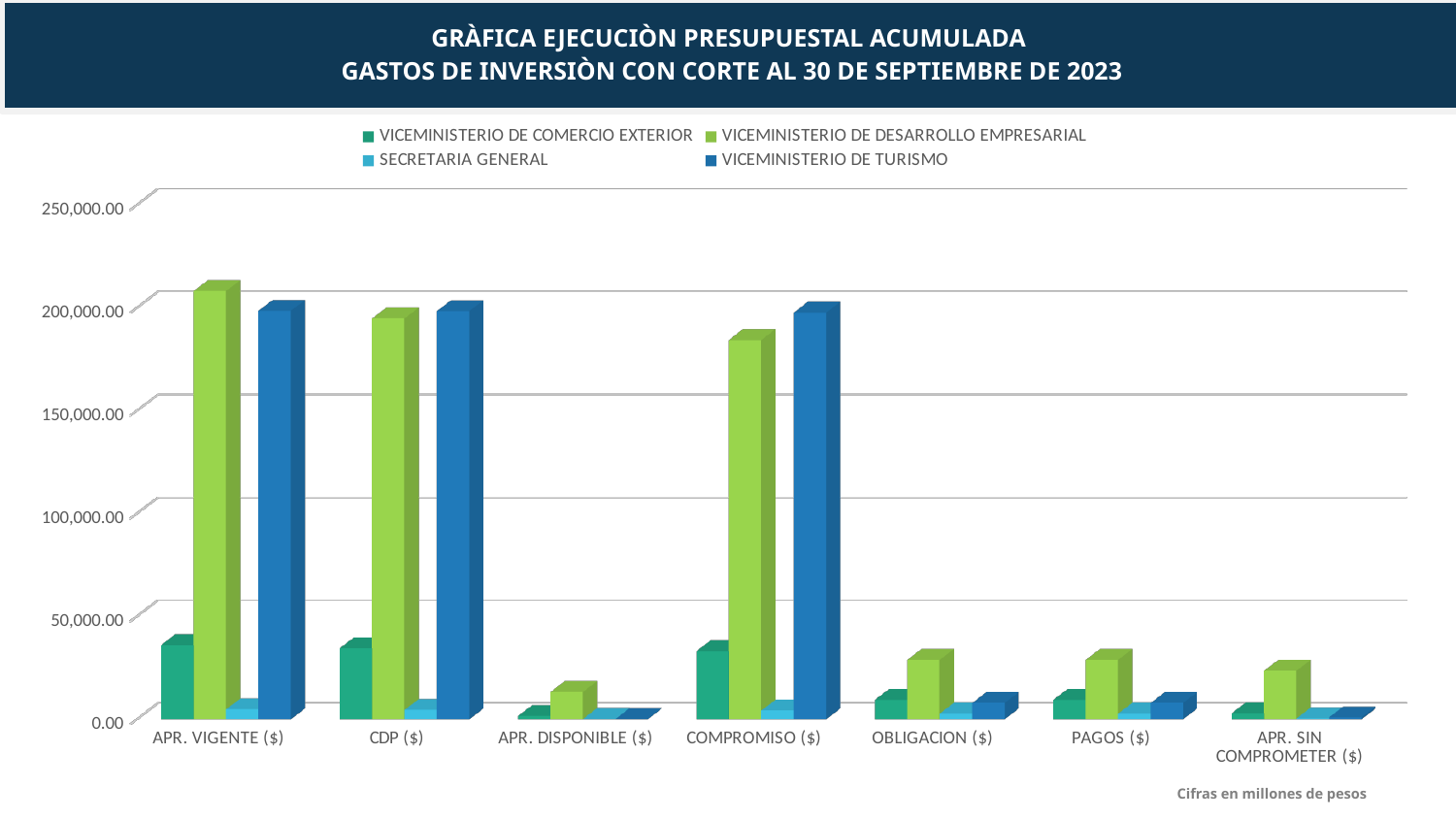
Is the value for VICEMINISTERIO DE DESARROLLO EMPRESARIAL in APR. VIGENTE ($) greater or less than 150,000.00? greater In which category does VICEMINISTERIO DE DESARROLLO EMPRESARIAL have its lowest value? APR. DISPONIBLE ($) Is the value for VICEMINISTERIO DE DESARROLLO EMPRESARIAL in COMPROMISO ($) greater or less than 200,000.00? less Is the value for VICEMINISTERIO DE TURISMO in CDP ($) greater or less than 150,000.00? greater According to the note below the chart, in what units are the figures expressed? millones de pesos In which category does VICEMINISTERIO DE DESARROLLO EMPRESARIAL have its highest value? APR. VIGENTE ($) How many categories are shown along the x axis? 7 Which series has the lowest value in the APR. VIGENTE ($) category? SECRETARIA GENERAL What kind of chart is shown on the slide? bar chart In the OBLIGACION ($) category, which is larger: VICEMINISTERIO DE DESARROLLO EMPRESARIAL or VICEMINISTERIO DE COMERCIO EXTERIOR? VICEMINISTERIO DE DESARROLLO EMPRESARIAL How many series does the legend list? 4